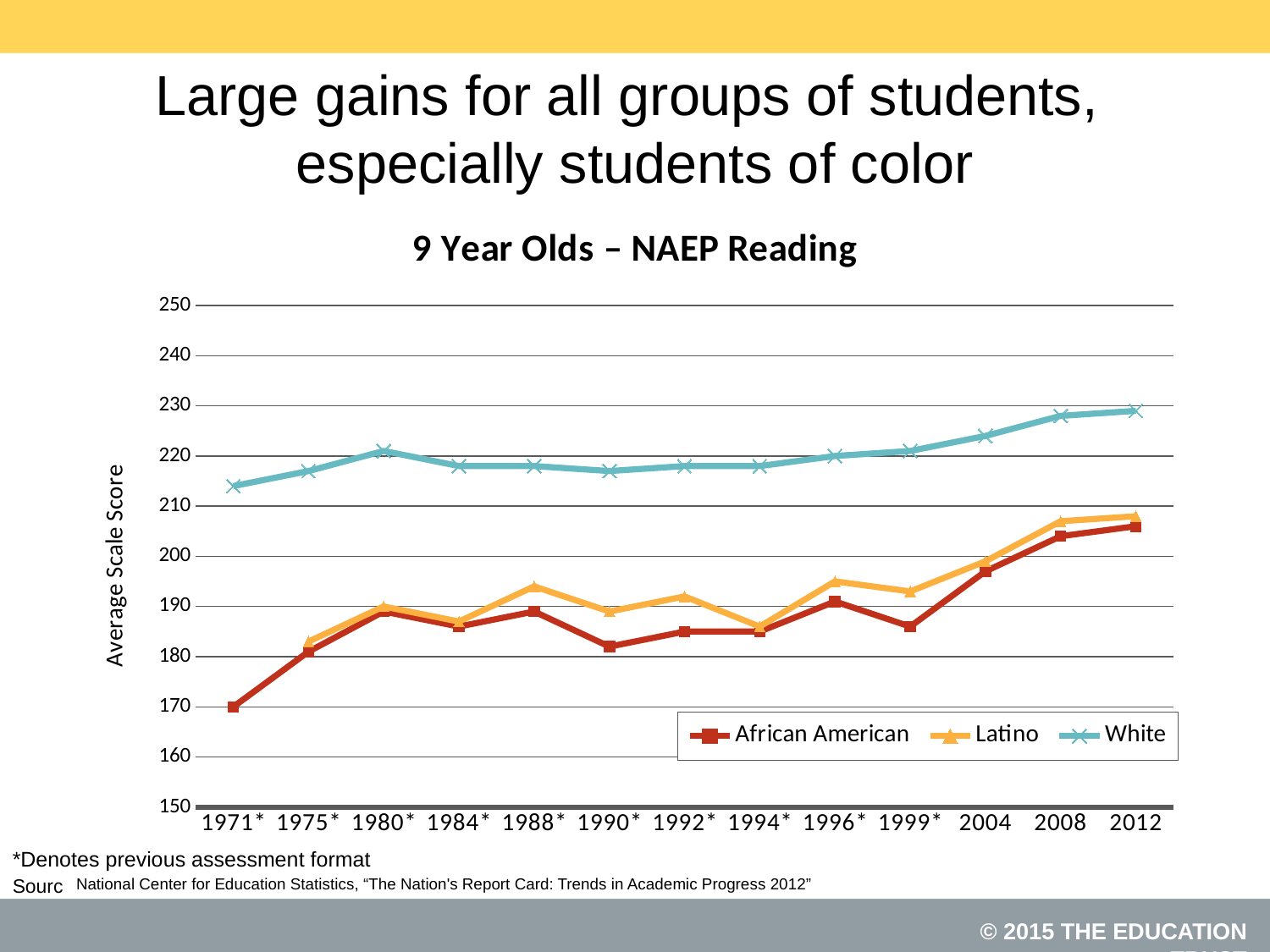
In which year is the African American score at its lowest? 1971* Is the White score in 2012 greater or less than 220? greater What is the chart's title? 9 Year Olds – NAEP Reading What type of chart is shown on the slide? line chart Is the African American score in 1990* greater or less than 190? less Does the White score rise or fall overall from 1971* to 2012? rise What is the African American average scale score in 1971*? 170 How many assessment years are plotted along the x axis? 13 How many series does the legend list? 3 Which group has the highest average scale score in 2012? White What is the label on the vertical axis? Average Scale Score In 1988*, which group scored higher, Latino or African American? Latino